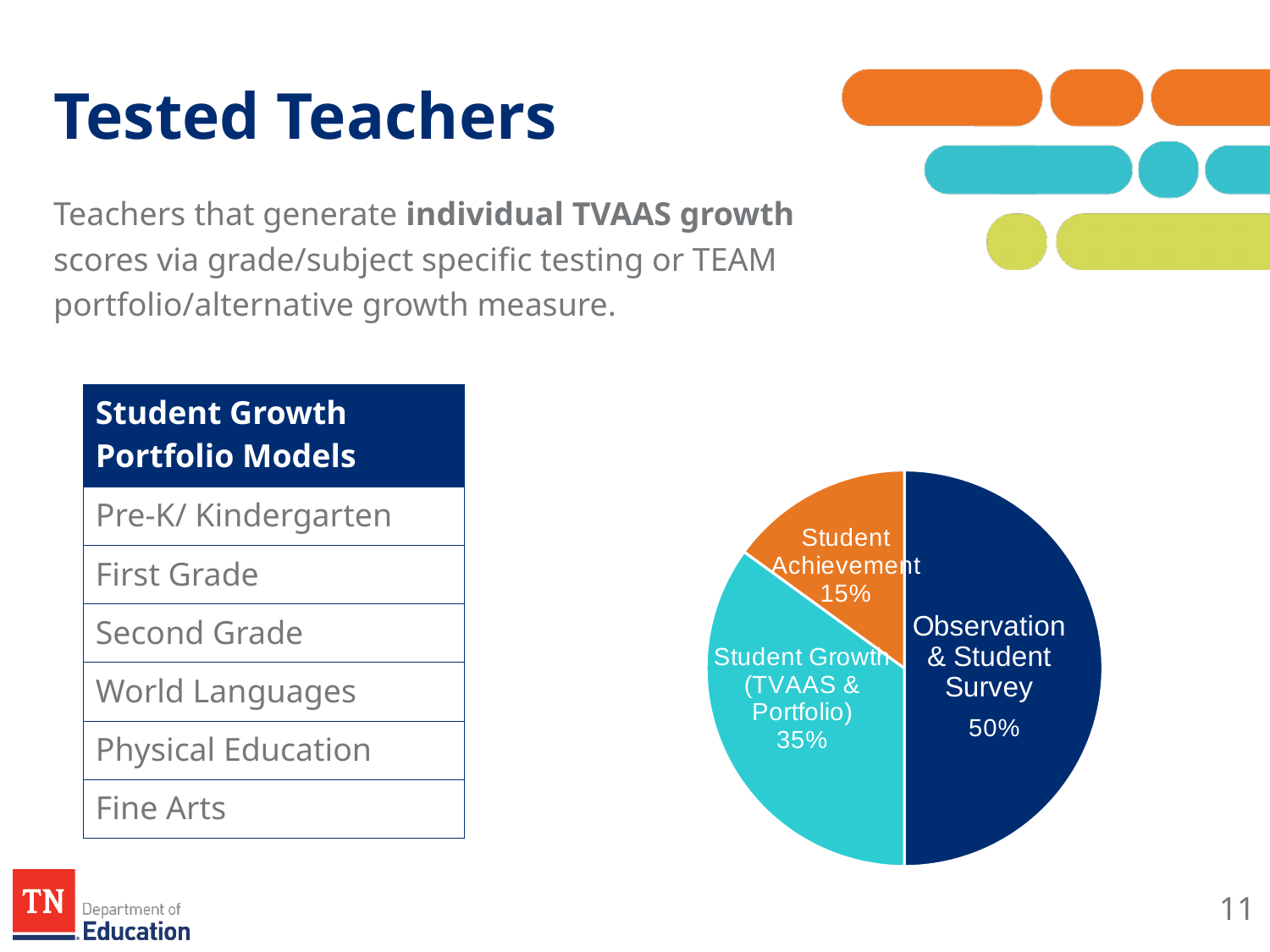
What share of the pie does Observation & Student Survey represent? 50% Which slice of the pie chart is the smallest? Student Achievement What share of the pie does Student Achievement represent? 15% Which is larger, the Student Growth (TVAAS & Portfolio) slice or the Student Achievement slice? Student Growth (TVAAS & Portfolio) What share of the pie does Student Growth (TVAAS & Portfolio) represent? 35% What colour is the Observation & Student Survey slice of the pie chart? dark blue What colour is the Student Achievement slice of the pie chart? orange What kind of chart is shown on the slide? pie chart What is the difference in percentage points between Observation & Student Survey and Student Growth (TVAAS & Portfolio)? 15 How many slices does the pie chart have? 3 What is the difference in percentage points between Student Growth (TVAAS & Portfolio) and Student Achievement? 20 Which slice of the pie chart is the largest? Observation & Student Survey